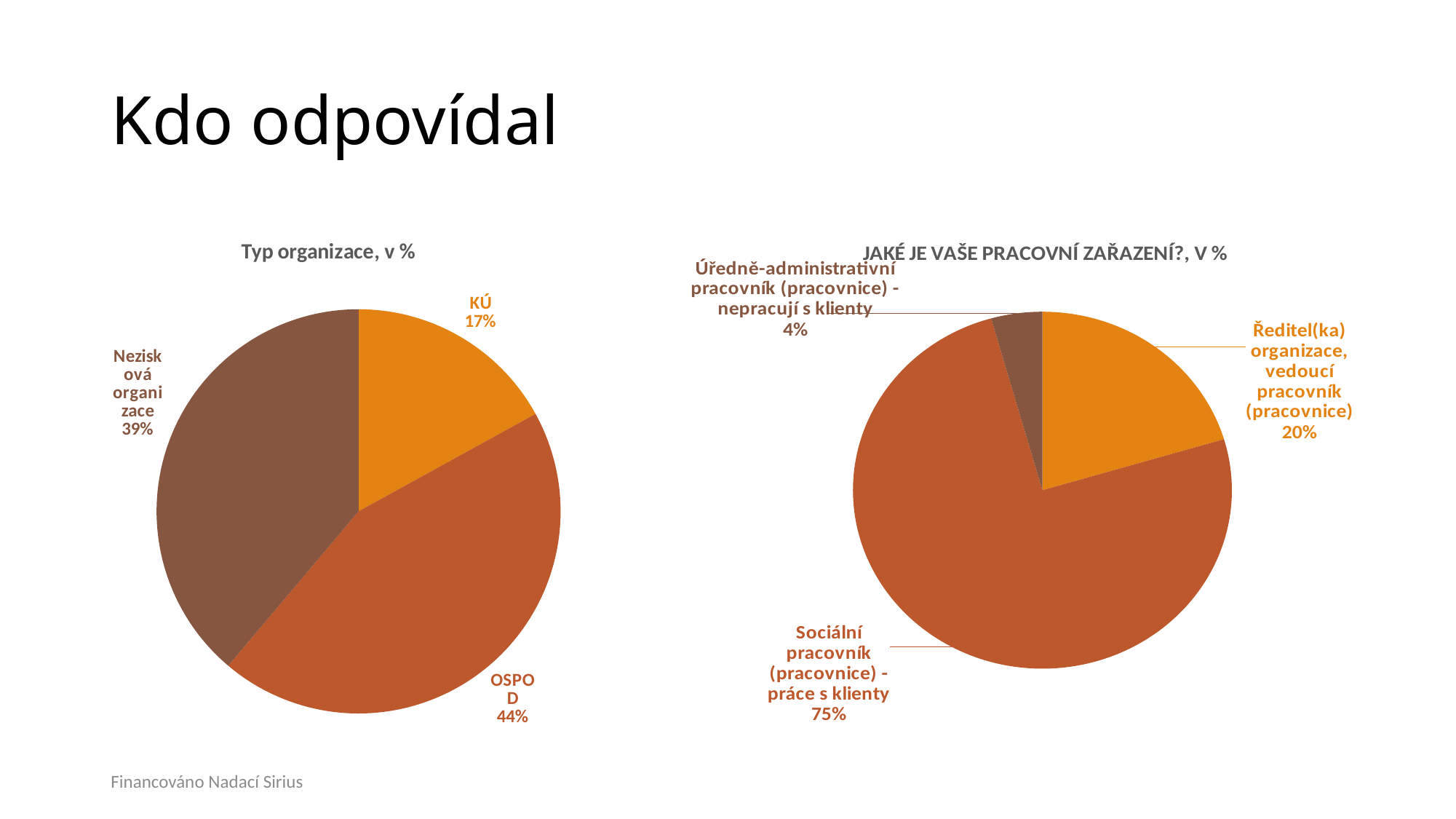
In the 'Typ organizace, v %' chart, what is the difference between the OSPOD and KÚ shares? 27% In the 'JAKÉ JE VAŠE PRACOVNÍ ZAŘAZENÍ?, V %' chart, what share do Úředně-administrativní pracovník (pracovnice) - nepracují s klienty have? 4% In the 'JAKÉ JE VAŠE PRACOVNÍ ZAŘAZENÍ?, V %' chart, which category has the smallest share? Úředně-administrativní pracovník (pracovnice) - nepracují s klienty In the 'Typ organizace, v %' chart, what share does Nezisková organizace have? 39% In the 'Typ organizace, v %' chart, which category has the smallest share? KÚ In the 'JAKÉ JE VAŠE PRACOVNÍ ZAŘAZENÍ?, V %' chart, what is the difference between the Sociální pracovník share and the Ředitel(ka) organizace, vedoucí pracovník share? 55% In the 'Typ organizace, v %' chart, which category has the largest share? OSPOD In the 'JAKÉ JE VAŠE PRACOVNÍ ZAŘAZENÍ?, V %' chart, what share do Sociální pracovník (pracovnice) - práce s klienty have? 75% In the 'Typ organizace, v %' chart, what share does KÚ have? 17% In the 'Typ organizace, v %' chart, what share does OSPOD have? 44% What type of chart is the 'JAKÉ JE VAŠE PRACOVNÍ ZAŘAZENÍ?, V %' chart? Pie chart In the 'Typ organizace, v %' chart, how many slices does the pie have? 3